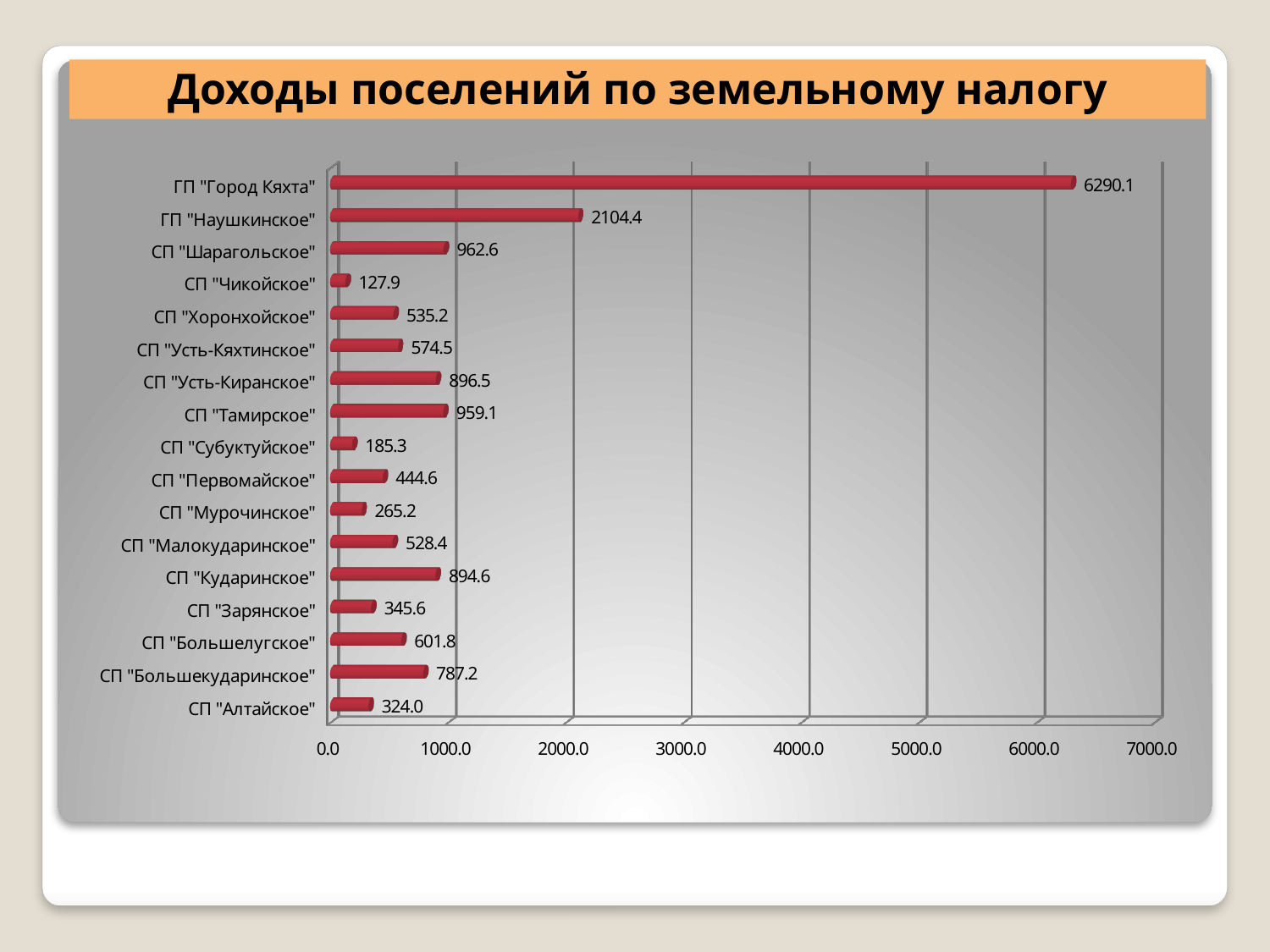
Which is larger, the value for СП "Большелугское" or СП "Хоронхойское"? СП "Большелугское" What is the title of the chart? Доходы поселений по земельному налогу How many categories are shown in the chart? 17 What is the difference between the values for СП "Большекударинское" and СП "Алтайское"? 463.2 What is the difference between the values for ГП "Город Кяхта" and ГП "Наушкинское"? 4185.7 Which category has the lowest value? СП "Чикойское" What is the value for СП "Тамирское"? 959.1 Is the value for ГП "Наушкинское" greater or less than 2000.0? greater Which category has the highest value? ГП "Город Кяхта" What kind of chart is shown on the slide? bar chart What is the value for ГП "Город Кяхта"? 6290.1 What is the value for СП "Большекударинское"? 787.2